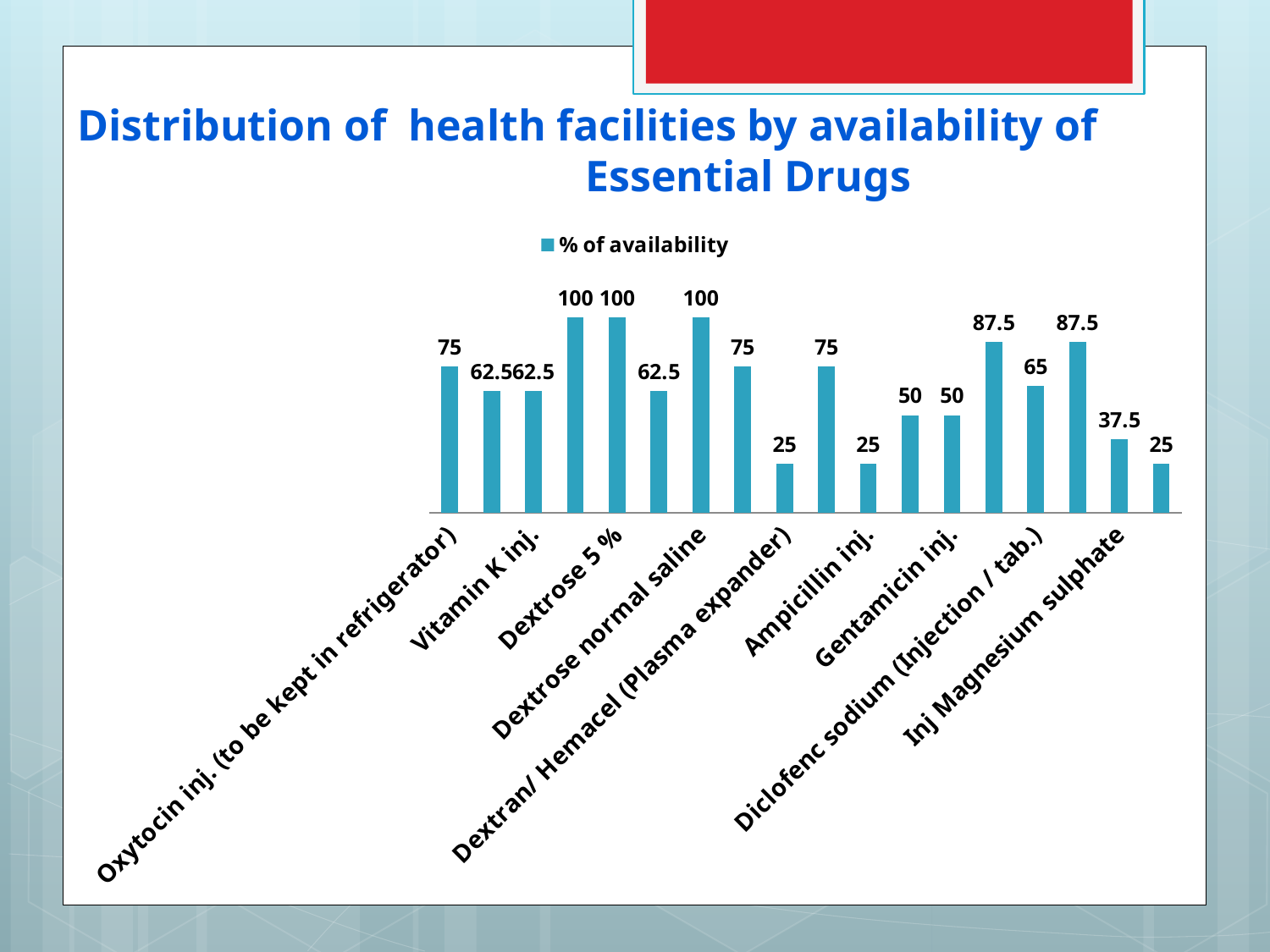
What is the name of the series shown in the legend? % of availability What is the % of availability for Gentamicin inj.? 50 What is the % of availability for Inj Magnesium sulphate? 37.5 How many series does the legend list? 1 What is the title of the chart on the slide? Distribution of health facilities by availability of Essential Drugs What kind of chart is shown on the slide? bar chart What is the % of availability for Oxytocin inj. (to be kept in refrigerator)? 75 What is the highest value shown on any bar in the chart? 100 What is the lowest value shown on any bar in the chart? 25 Which has a higher % of availability, Diclofenc sodium (Injection / tab.) or Dextran/ Hemacel (Plasma expander)? Diclofenc sodium (Injection / tab.) What is the % of availability for Dextrose 5 %? 100 How many bars are plotted in the chart? 18